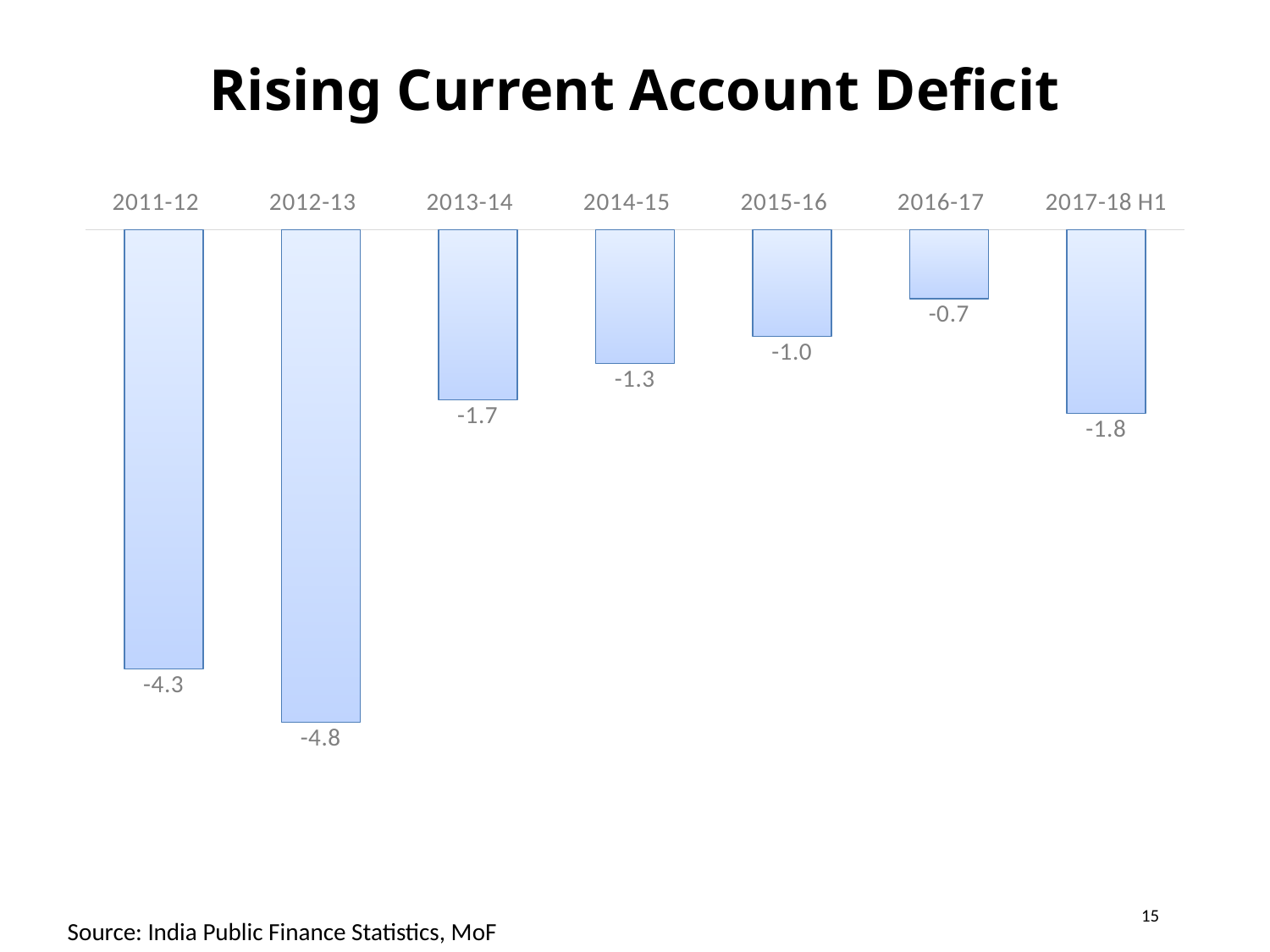
Which has the larger deficit, 2015-16 or 2017-18 H1? 2017-18 H1 Which year has the highest value (the smallest deficit)? 2016-17 What is the value for 2016-17? -0.7 Which year has the lowest value (the largest deficit)? 2012-13 What is the value for 2017-18 H1? -1.8 How many years (categories) are shown in the chart? 7 Do the values rise or fall from 2012-13 to 2016-17? Rise What is the difference between the values for 2012-13 and 2011-12? 0.5 What is the difference between the values for 2013-14 and 2014-15? 0.4 What is the title of the chart? Rising Current Account Deficit What is the value for 2011-12? -4.3 What kind of chart is shown on the slide? Bar chart